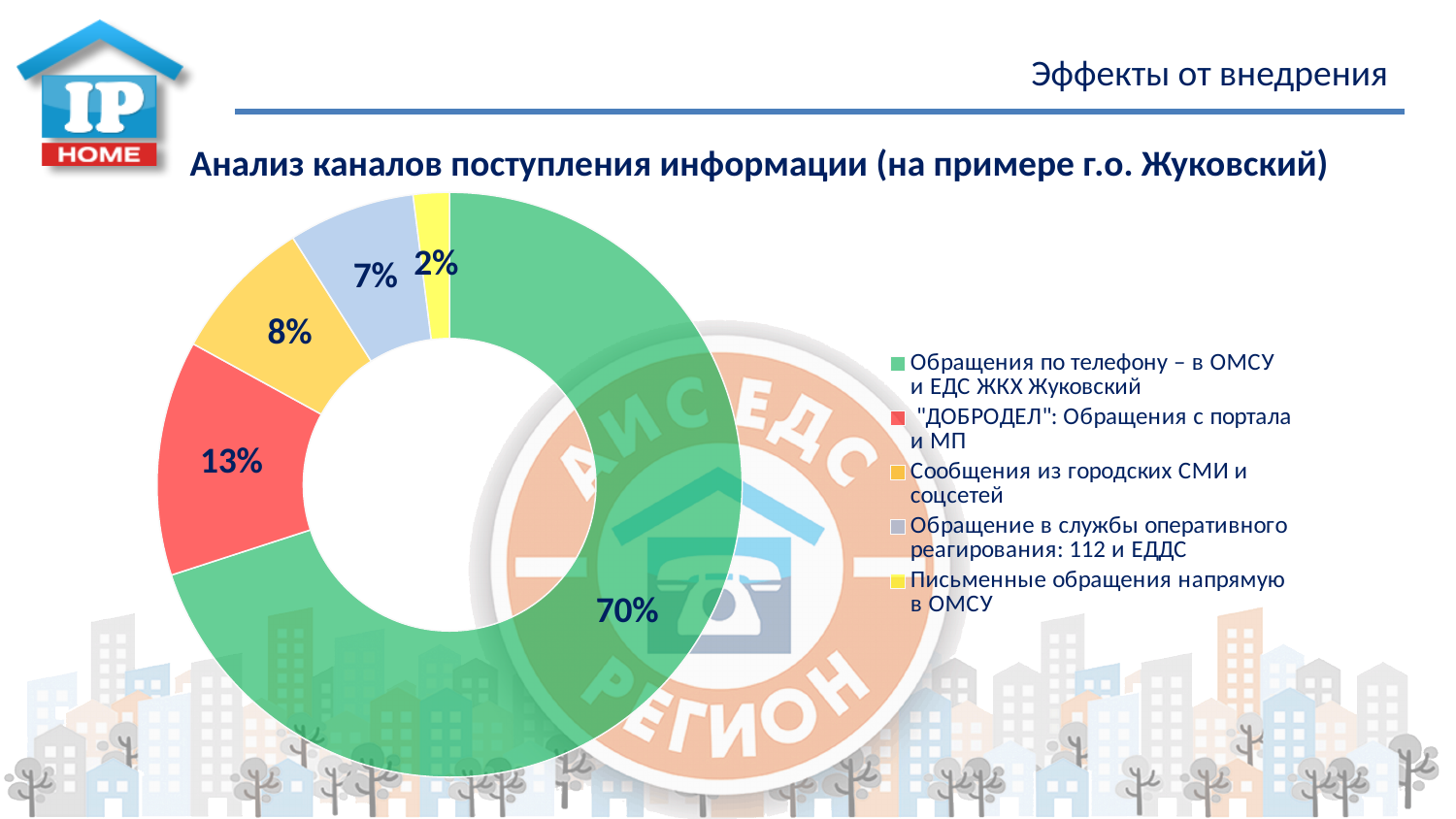
What is the value for "Сообщения из городских СМИ и соцсетей"? 8% What is the value for "Письменные обращения напрямую в ОМСУ"? 2% What is the value for ""ДОБРОДЕЛ": Обращения с портала и МП"? 13% What kind of chart is shown on the slide? Doughnut chart What share of the pie does "Обращения по телефону – в ОМСУ и ЕДС ЖКХ Жуковский" have? 70% How many categories does the chart show? 5 Which is larger: the share for "Сообщения из городских СМИ и соцсетей" or the share for "Обращение в службы оперативного реагирования: 112 и ЕДДС"? Сообщения из городских СМИ и соцсетей Which category has the smallest share of the pie? Письменные обращения напрямую в ОМСУ What is the difference between the share for ""ДОБРОДЕЛ": Обращения с портала и МП" and the share for "Сообщения из городских СМИ и соцсетей"? 5% What is the title of the chart? Анализ каналов поступления информации (на примере г.о. Жуковский) What is the value for "Обращение в службы оперативного реагирования: 112 и ЕДДС"? 7% Which category has the largest share of the pie? Обращения по телефону – в ОМСУ и ЕДС ЖКХ Жуковский